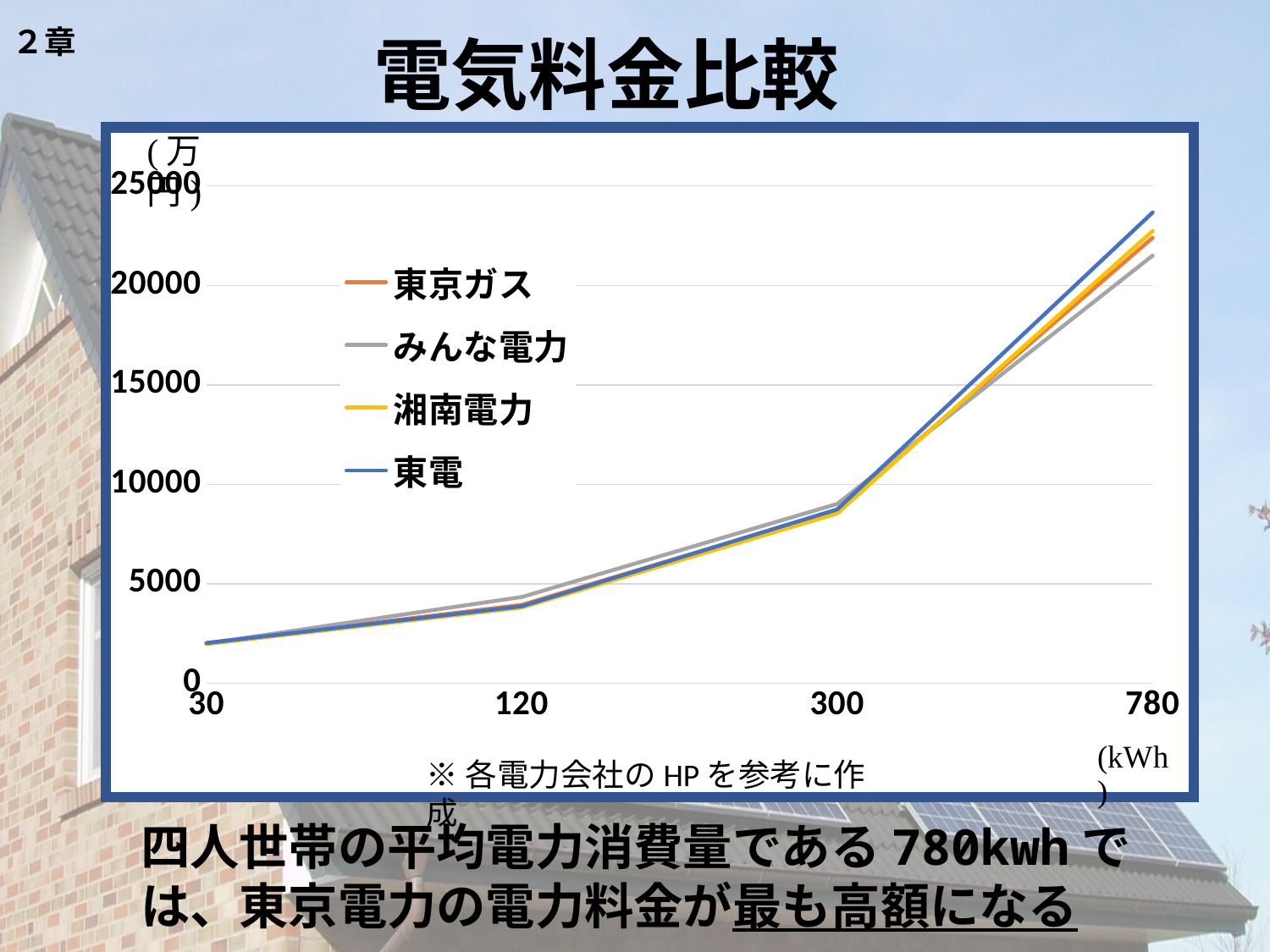
Which series has the highest value at 780 kWh? 東電 How many series does the legend list? 4 Do the electricity charges rise or fall as consumption increases from 30 to 780 kWh? rise Is the value for 東京ガス at 300 kWh greater or less than 10000? less Which series is plotted with the blue line? 東電 What kind of chart is shown on the slide? line chart How many consumption levels (x-axis points) are plotted? 4 What is the title of the chart? 電気料金比較 Is the value for 湘南電力 at 120 kWh greater or less than 5000? less At 120 kWh, which is larger: the value for みんな電力 or the value for 東電? みんな電力 Is the value for 東電 at 780 kWh greater or less than 20000? greater Which series has the lowest value at 780 kWh? みんな電力